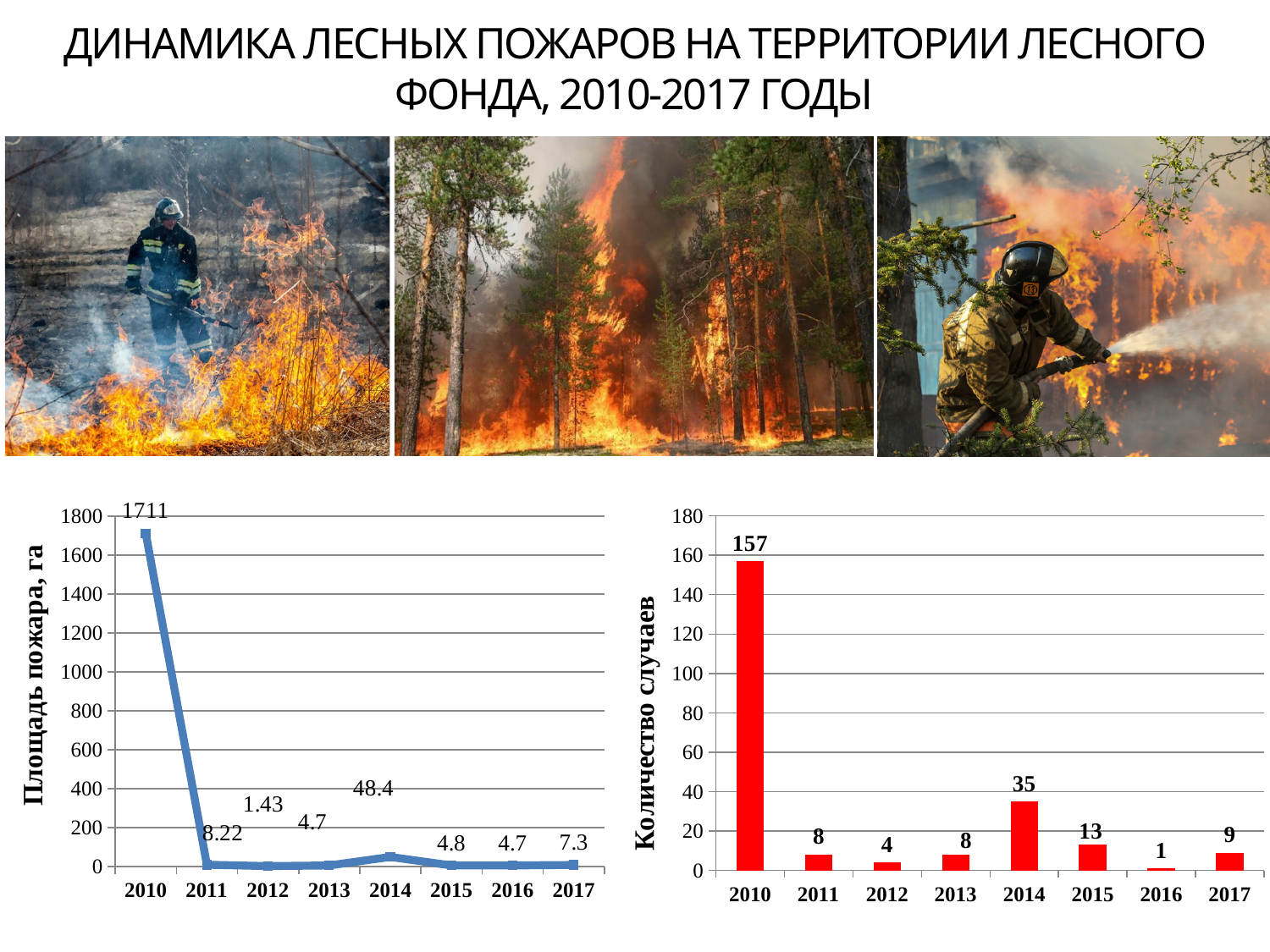
What kind of chart is the left chart (Площадь пожара, га)? line chart In the right chart (Количество случаев), which is larger, the value for 2013 or the value for 2017? 2017 In the right chart (Количество случаев), what is the difference between the values for 2014 and 2015? 22 In the left chart (Площадь пожара, га), what is the value for 2010? 1711 In the right chart (Количество случаев), what is the value for 2015? 13 What is the y-axis label of the right chart? Количество случаев What kind of chart is the right chart (Количество случаев)? bar chart In the right chart (Количество случаев), which year has the highest value? 2010 In the left chart (Площадь пожара, га), what is the value for 2014? 48.4 In the right chart (Количество случаев), which year has the lowest value? 2016 In the left chart (Площадь пожара, га), which year has the lowest value? 2012 In the left chart (Площадь пожара, га), how many years are plotted? 8